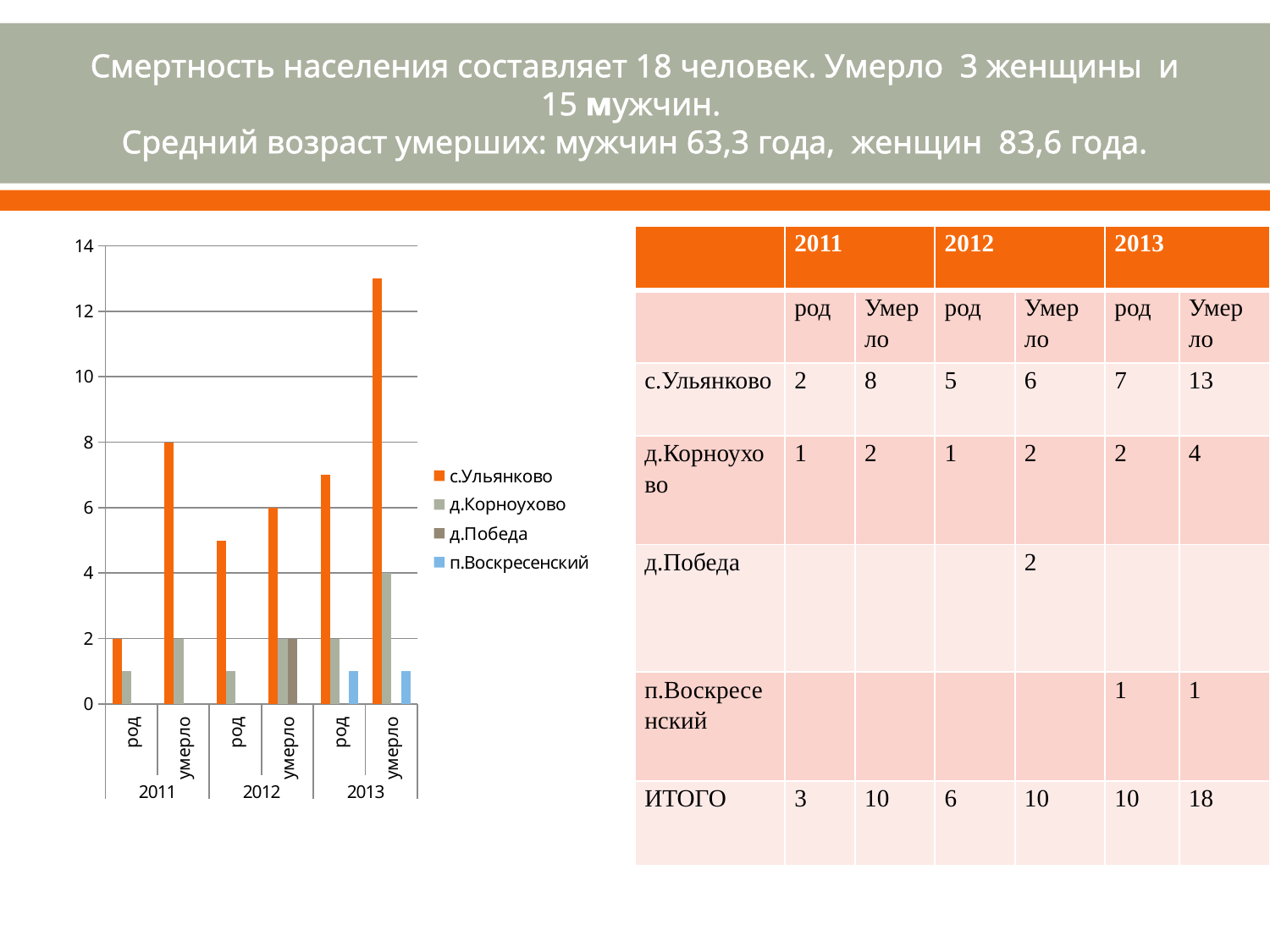
Which series and category has the tallest bar in the chart? с.Ульянково, умерло 2013 What is the value for с.Ульянково in the 'умерло' category for 2011? 8 What kind of chart is shown on the slide? bar chart Is the value for с.Ульянково in 'умерло' 2013 greater or less than 12? greater Is the value for с.Ульянково in 'род' 2013 greater or less than 6? greater What colour represents с.Ульянково in the chart legend? orange What is the value for с.Ульянково in the 'умерло' category for 2012? 6 How many series does the chart legend list? 4 What is the difference between the с.Ульянково 'умерло' values for 2011 and 2012? 2 How many categories are shown along the x axis of the chart? 6 What is the value for д.Корноухово in the 'умерло' category for 2013? 4 Which is larger for с.Ульянково: the 'умерло' value in 2011 or in 2012? 2011